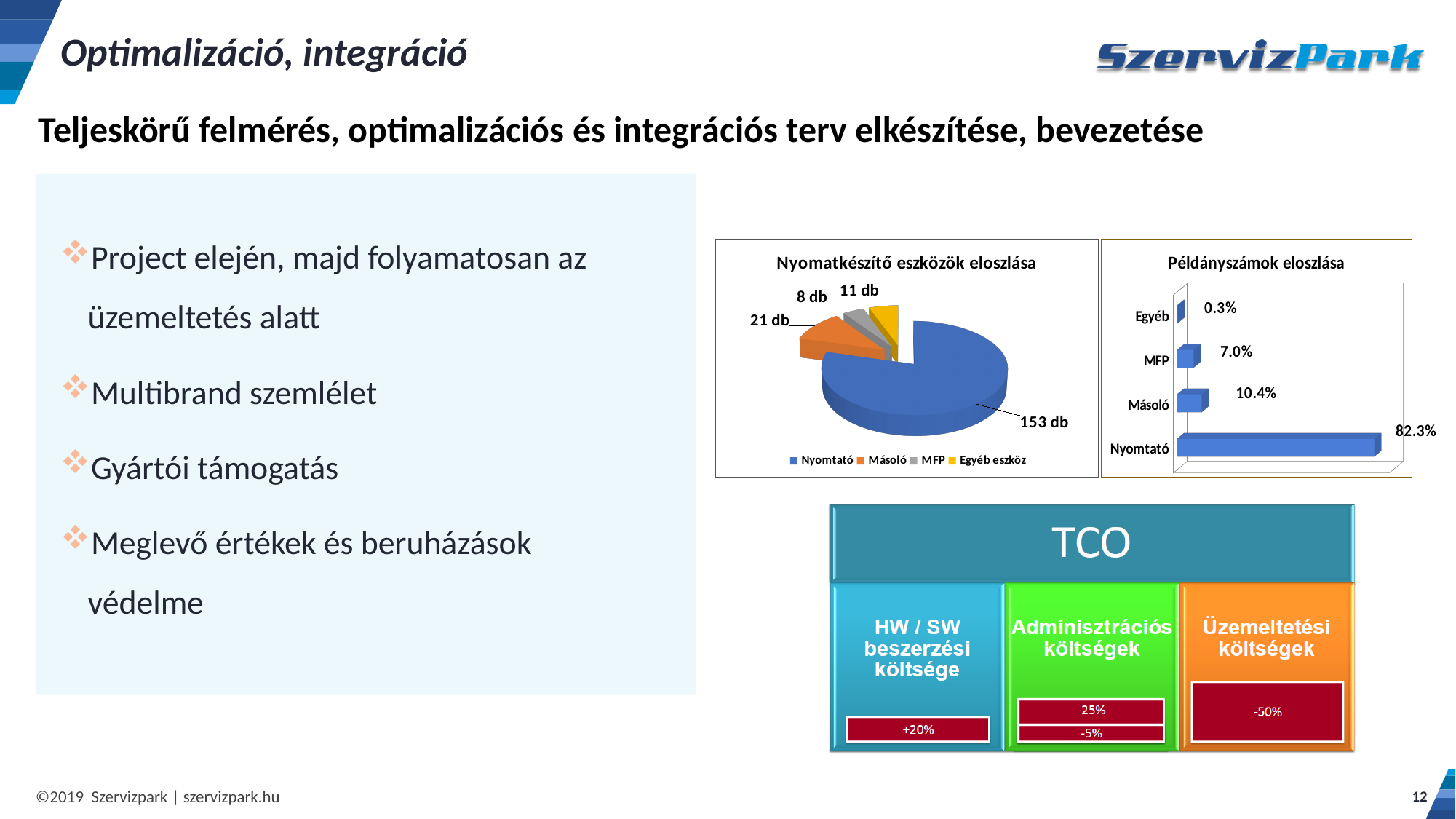
In the pie chart 'Nyomatkészítő eszközök eloszlása', how many categories does the legend list? 4 In the chart 'Példányszámok eloszlása', what is the difference between Nyomtató and Másoló? 71.9% In the pie chart 'Nyomatkészítő eszközök eloszlása', what is the value for Másoló? 21 db In the pie chart 'Nyomatkészítő eszközök eloszlása', which is larger, Egyéb eszköz or MFP? Egyéb eszköz In the pie chart 'Nyomatkészítő eszközök eloszlása', what is the difference between the Nyomtató and Másoló values? 132 db In the chart 'Példányszámok eloszlása', what is the value for Másoló? 10.4% In the chart 'Példányszámok eloszlása', what is the value for Egyéb? 0.3% In the pie chart 'Nyomatkészítő eszközök eloszlása', which category has the smallest slice? MFP In the pie chart 'Nyomatkészítő eszközök eloszlása', what is the value for Nyomtató? 153 db In the chart 'Példányszámok eloszlása', which category has the highest value? Nyomtató What kind of chart is 'Példányszámok eloszlása'? Bar chart What kind of chart is 'Nyomatkészítő eszközök eloszlása'? Pie chart